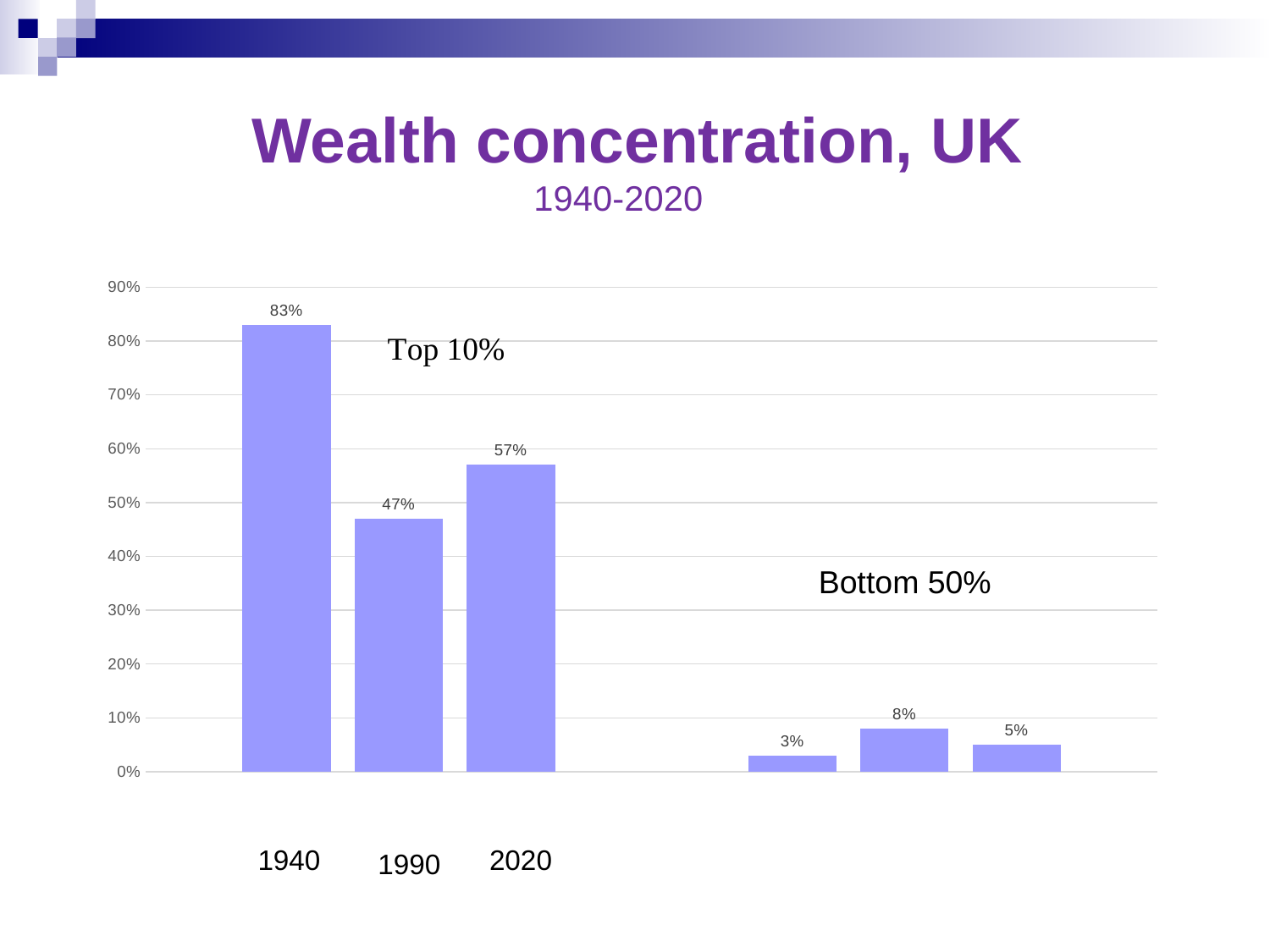
What is the value for the Top 10% in 1940? 83% What is the difference between the Top 10% values for 1940 and 2020? 26% What is the highest value shown among the Bottom 50% bars? 8% What is the value for the Top 10% in 2020? 57% Which year has the lowest value for the Top 10%? 1990 What is the value for the Top 10% in 1990? 47% What kind of chart is shown on the slide? bar chart What is the lowest value shown among the Bottom 50% bars? 3% Which is larger, the Top 10% value for 1990 or for 2020? 2020 Which year has the highest value for the Top 10%? 1940 How many bars are plotted in the chart in total? 6 What is the title of the slide containing the chart? Wealth concentration, UK